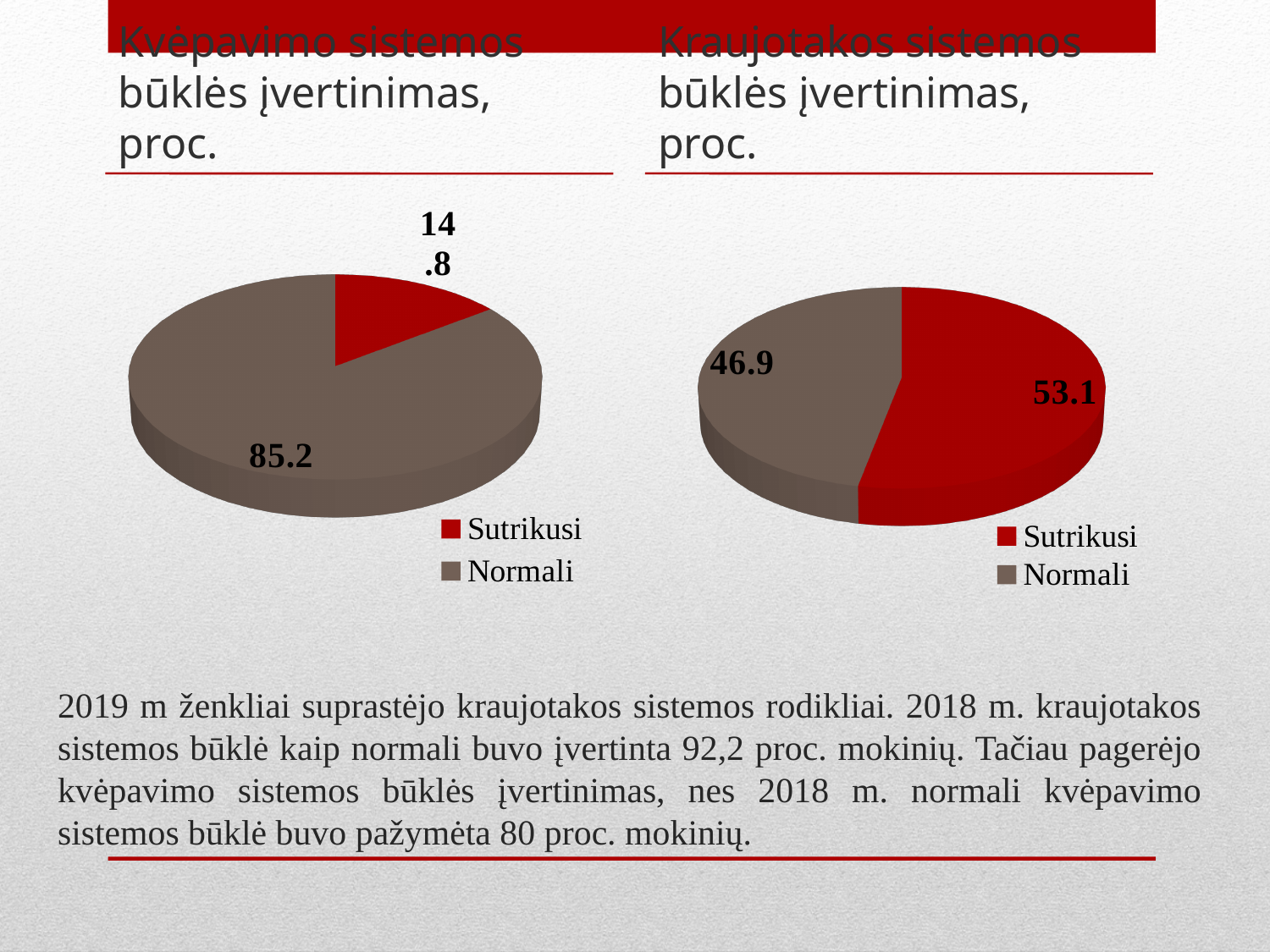
In the right chart (Kraujotakos sistemos), which category has the smallest slice? Normali In the chart titled 'Kvėpavimo sistemos būklės įvertinimas, proc.', what is the value for Sutrikusi? 14.8 In the left chart (Kvėpavimo sistemos), what is the difference between the Normali and Sutrikusi values? 70.4 In the chart titled 'Kraujotakos sistemos būklės įvertinimas, proc.', what is the value for Normali? 46.9 In the chart titled 'Kraujotakos sistemos būklės įvertinimas, proc.', what is the value for Sutrikusi? 53.1 What are the two legend entries in the right chart (Kraujotakos sistemos)? Sutrikusi, Normali In the right chart (Kraujotakos sistemos), what is the difference between the Sutrikusi and Normali values? 6.2 How many slices does the left chart (Kvėpavimo sistemos) have? 2 In the left chart (Kvėpavimo sistemos), which category has the largest slice? Normali In the right chart (Kraujotakos sistemos), which is larger, Sutrikusi or Normali? Sutrikusi In the chart titled 'Kvėpavimo sistemos būklės įvertinimas, proc.', what is the value for Normali? 85.2 What type of chart is used in the chart titled 'Kraujotakos sistemos būklės įvertinimas, proc.'? Pie chart